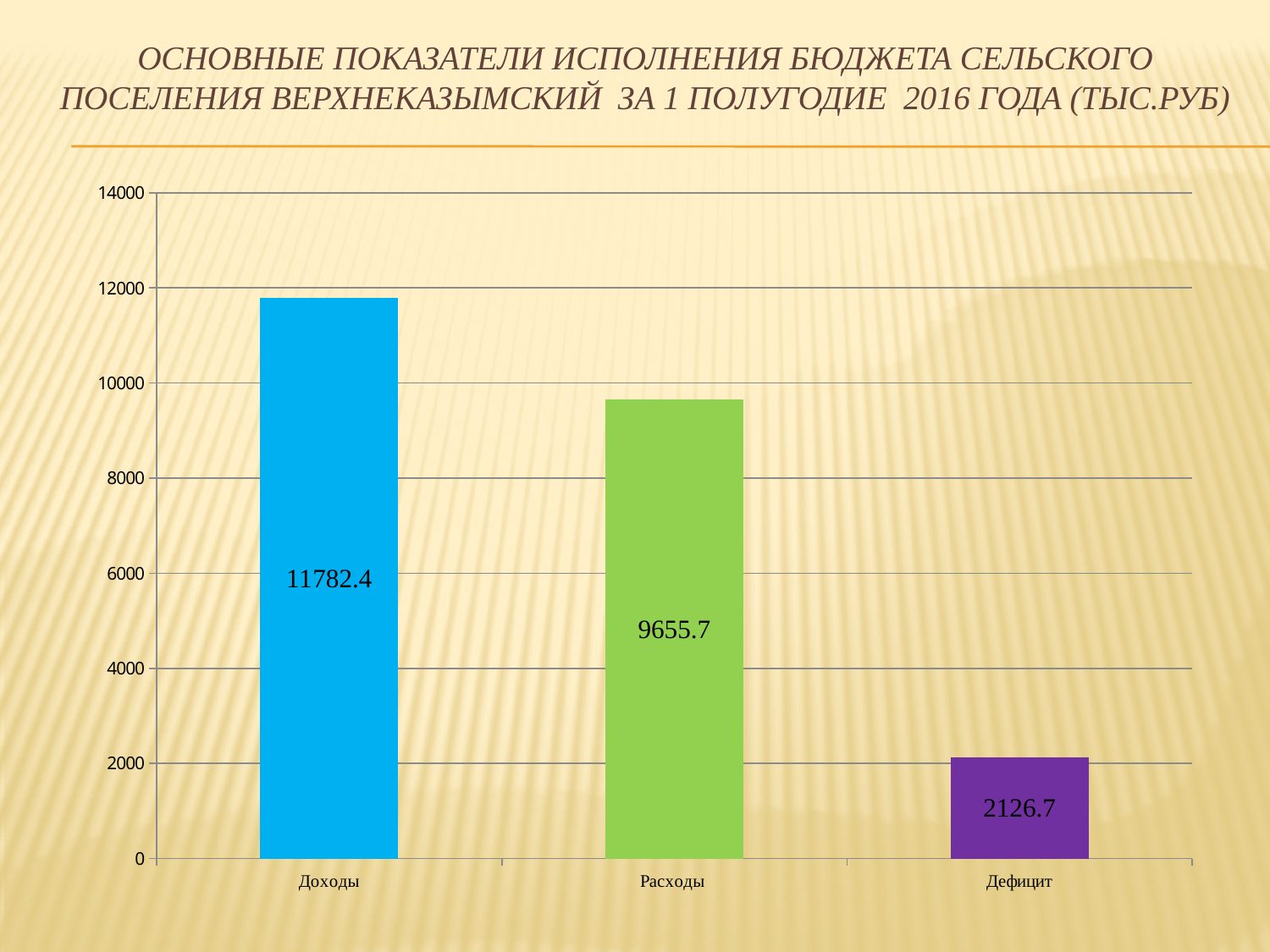
What is the difference between the values for Доходы and Расходы? 2126.7 Which category has the lowest value? Дефицит How many categories are shown on the x axis? 3 What is the difference between the values for Расходы and Дефицит? 7529.0 What kind of chart is shown on the slide? bar chart Which category has the highest value? Доходы What is the value for Дефицит? 2126.7 What is the value for Расходы? 9655.7 Is the value for Расходы greater or less than 10000? less What colour is the bar for Дефицит? purple Which is larger, the value for Расходы or the value for Дефицит? Расходы What is the value for Доходы? 11782.4